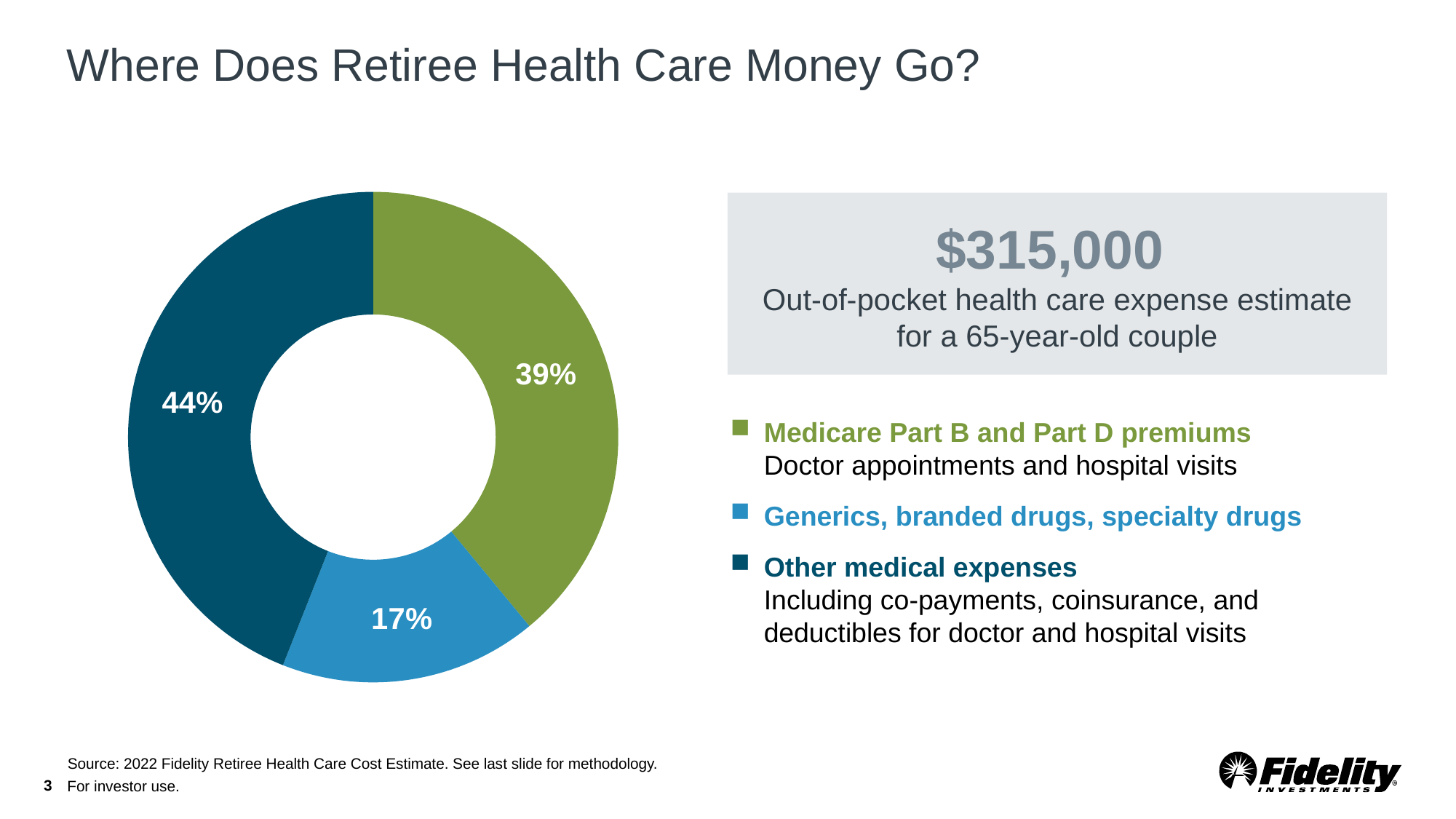
Which category has the largest slice in the donut chart? Other medical expenses What is the difference in percentage points between the Medicare Part B and Part D premiums slice and the Generics, branded drugs, specialty drugs slice? 22 What share of the donut chart is labelled for Other medical expenses (dark blue slice)? 44% What out-of-pocket health care expense estimate for a 65-year-old couple is shown next to the chart? $315,000 What kind of chart is shown on the slide? Donut (pie) chart How many slices does the donut chart have? 3 Which category has the smallest slice in the donut chart? Generics, branded drugs, specialty drugs What share of the donut chart is labelled for Medicare Part B and Part D premiums (green slice)? 39% What colour is the slice representing Other medical expenses? Dark blue What share of the donut chart is labelled for Generics, branded drugs, specialty drugs (light blue slice)? 17% Which is larger: the slice for Medicare Part B and Part D premiums or the slice for Generics, branded drugs, specialty drugs? Medicare Part B and Part D premiums What is the difference in percentage points between the Other medical expenses slice and the Medicare Part B and Part D premiums slice? 5